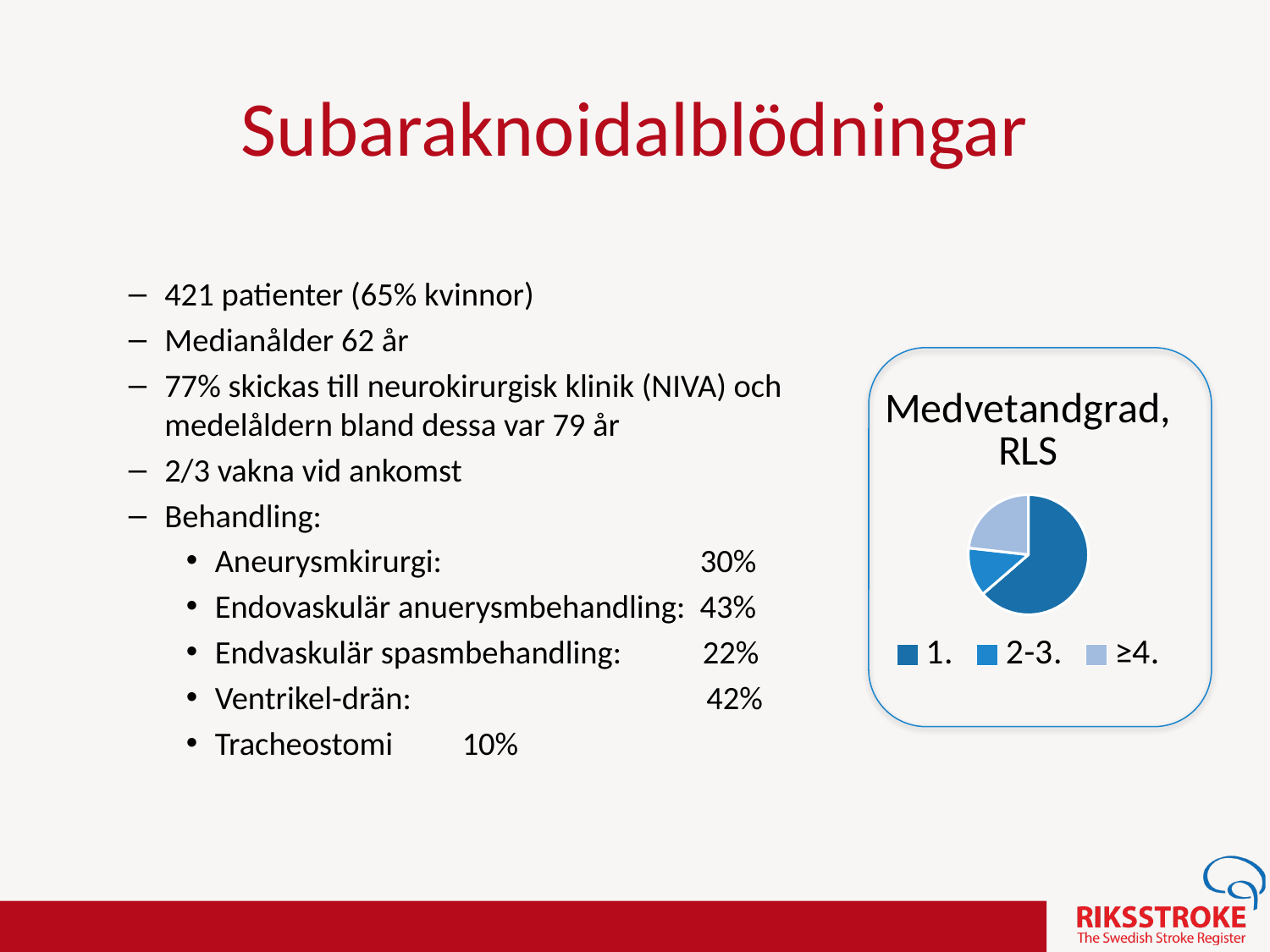
How many entries does the legend of the pie chart list? 3 In the pie chart, which slice is larger: 1. or 2-3.? 1. What is the title of the pie chart? Medvetandgrad, RLS Which category has the largest slice in the pie chart? 1. What are the legend entries of the pie chart? 1., 2-3., ≥4. In the pie chart, which slice is larger: 1. or ≥4.? 1. How many slices does the pie chart have? 3 What kind of chart is shown on the slide? pie chart